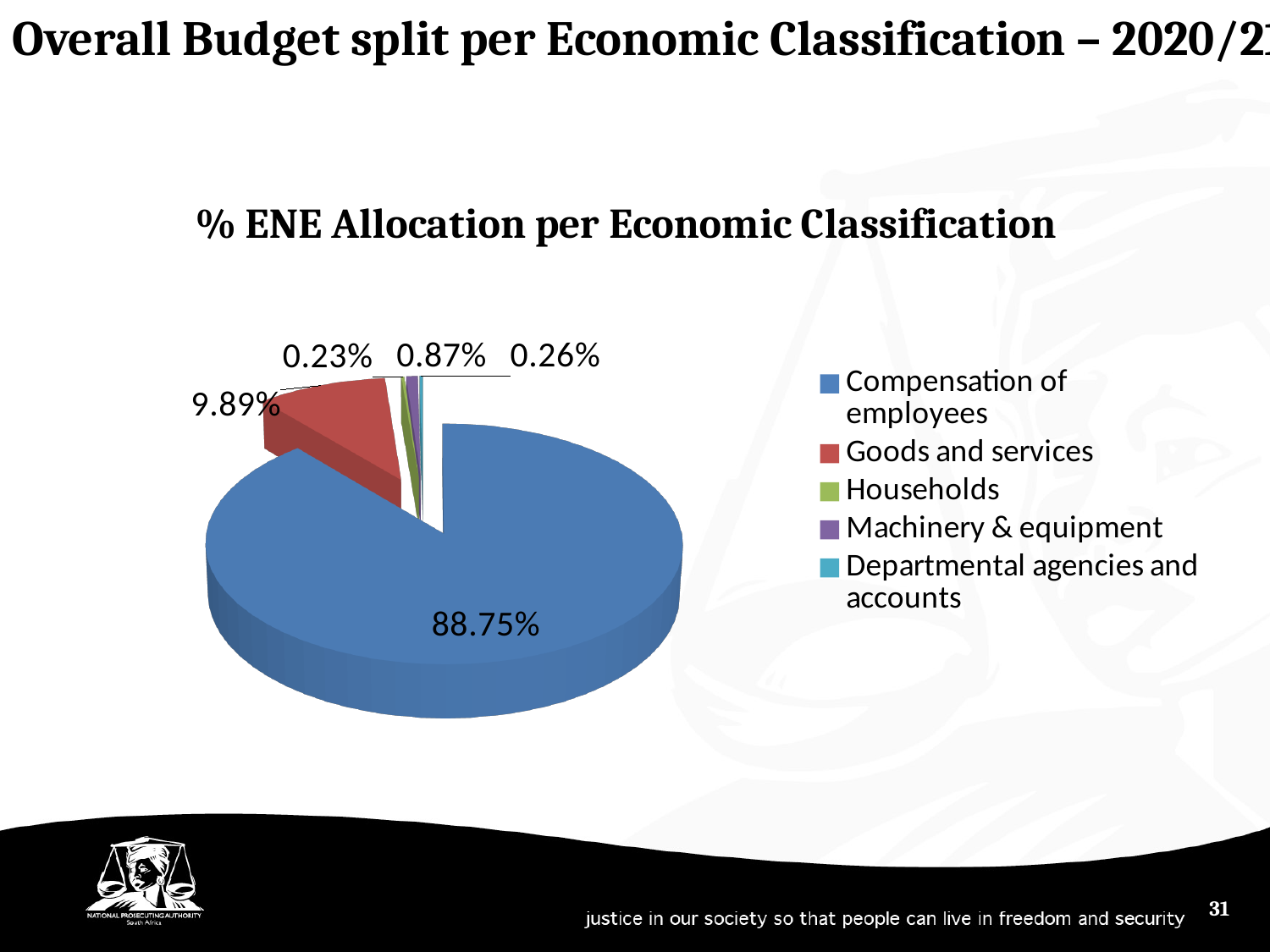
What type of chart is shown on the slide? Pie chart What is the combined share of Compensation of employees and Goods and services? 98.64% What is the difference in percentage points between the Compensation of employees share and the Goods and services share? 78.86% What is the title of the chart? % ENE Allocation per Economic Classification How many economic classifications are shown in the pie chart? 5 What colour is the slice for Goods and services? Red How many entries does the legend list? 5 What is the smallest percentage value labelled on the pie chart? 0.23% What percentage of the ENE allocation goes to Goods and services? 9.89% Which economic classification has the largest share of the ENE allocation? Compensation of employees What percentage of the ENE allocation goes to Compensation of employees? 88.75% Which is larger: the share for Goods and services or the share for Compensation of employees? Compensation of employees